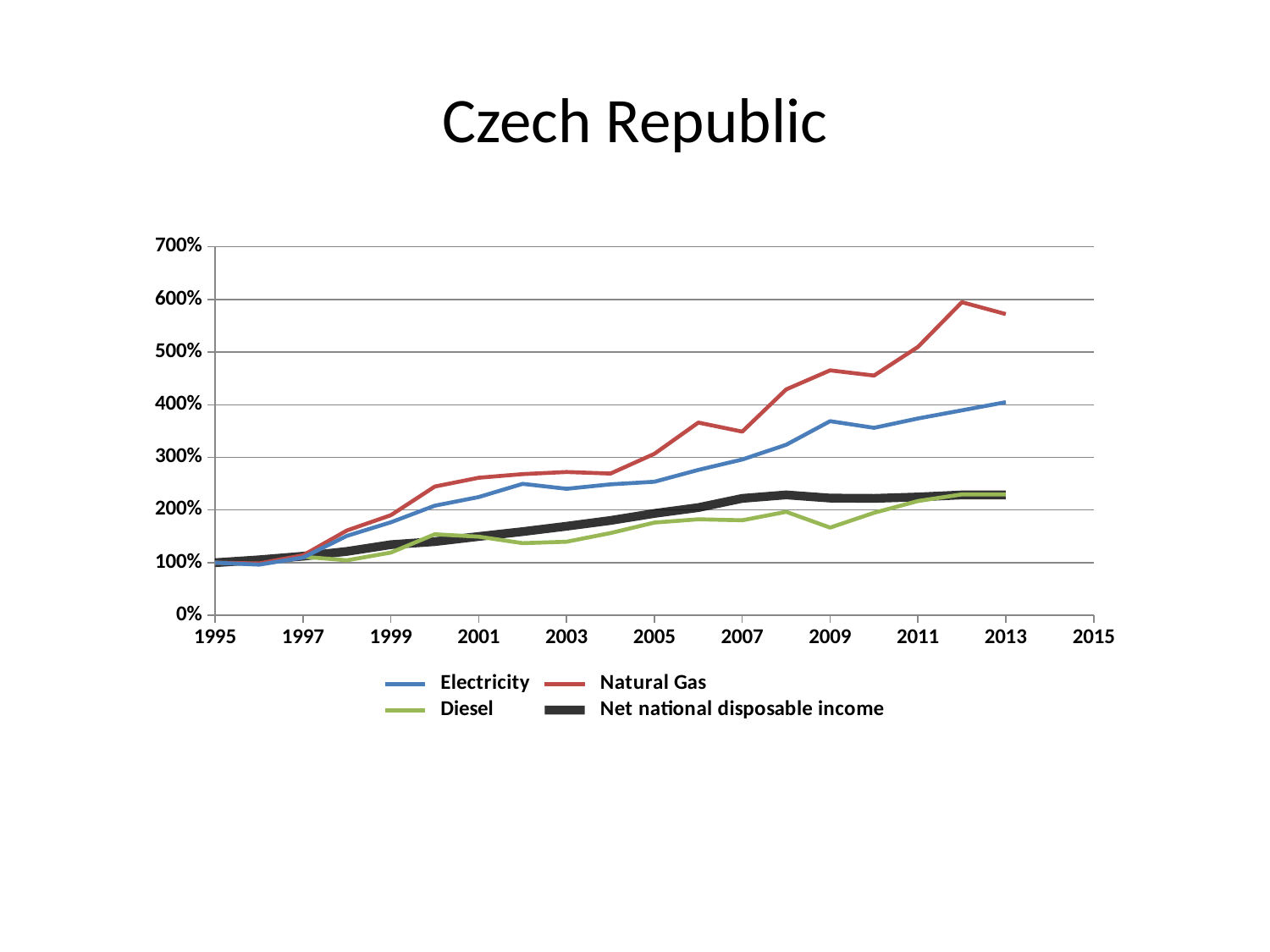
Is the value for Electricity in 2013 greater or less than 300%? greater In 2005, which is larger: Diesel or Electricity? Electricity Which series has the highest value in 2013? Natural Gas Is the value for Diesel in 2009 greater or less than 200%? less How many series does the legend list? 4 Is the value for Natural Gas in 2012 greater or less than 500%? greater In 2008, which is larger: Natural Gas or Electricity? Natural Gas What is the title of the slide? Czech Republic Does the Natural Gas series rise or fall overall from 1995 to 2013? rise What kind of chart is shown on the slide? line chart Which series has the lowest value in 2009? Diesel